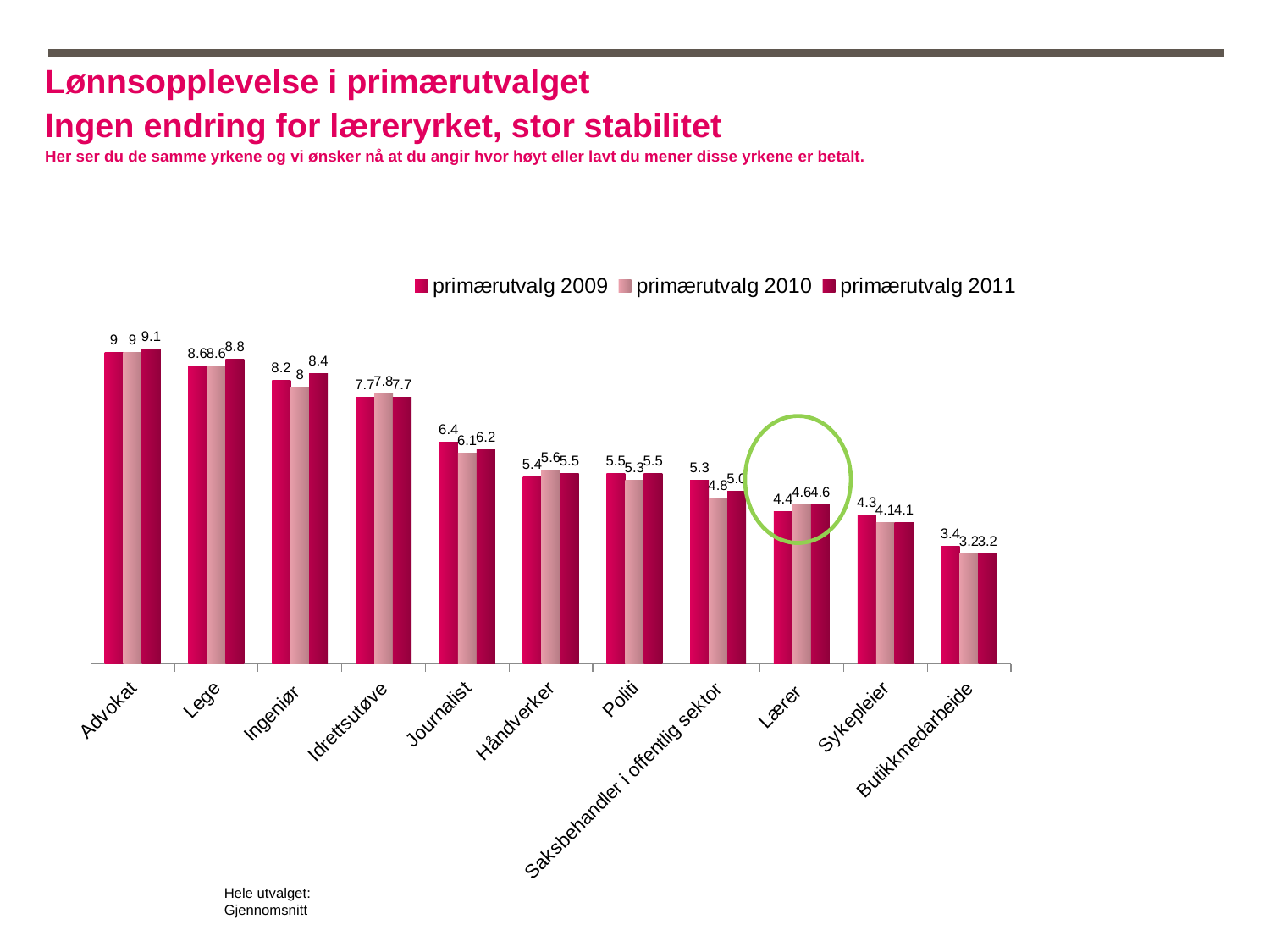
What kind of chart is shown on the slide? Bar chart How many series does the legend list? 3 Which category has the lowest value in the primærutvalg 2009 series? Butikkmedarbeide Do the primærutvalg 2011 values generally rise or fall from Advokat to Butikkmedarbeide? Fall Which is larger: the primærutvalg 2009 value for Saksbehandler i offentlig sektor or the primærutvalg 2010 value for Saksbehandler i offentlig sektor? primærutvalg 2009 Which category is highlighted with a green circle on the chart? Lærer How many categories are shown on the x axis? 11 What is the value for Lærer in the primærutvalg 2009 series? 4.4 What is the difference between the primærutvalg 2011 values for Advokat and Lærer? 4.5 What is the value for Ingeniør in the primærutvalg 2011 series? 8.4 What is the value for Journalist in the primærutvalg 2010 series? 6.1 Which category has the highest value in the primærutvalg 2011 series? Advokat